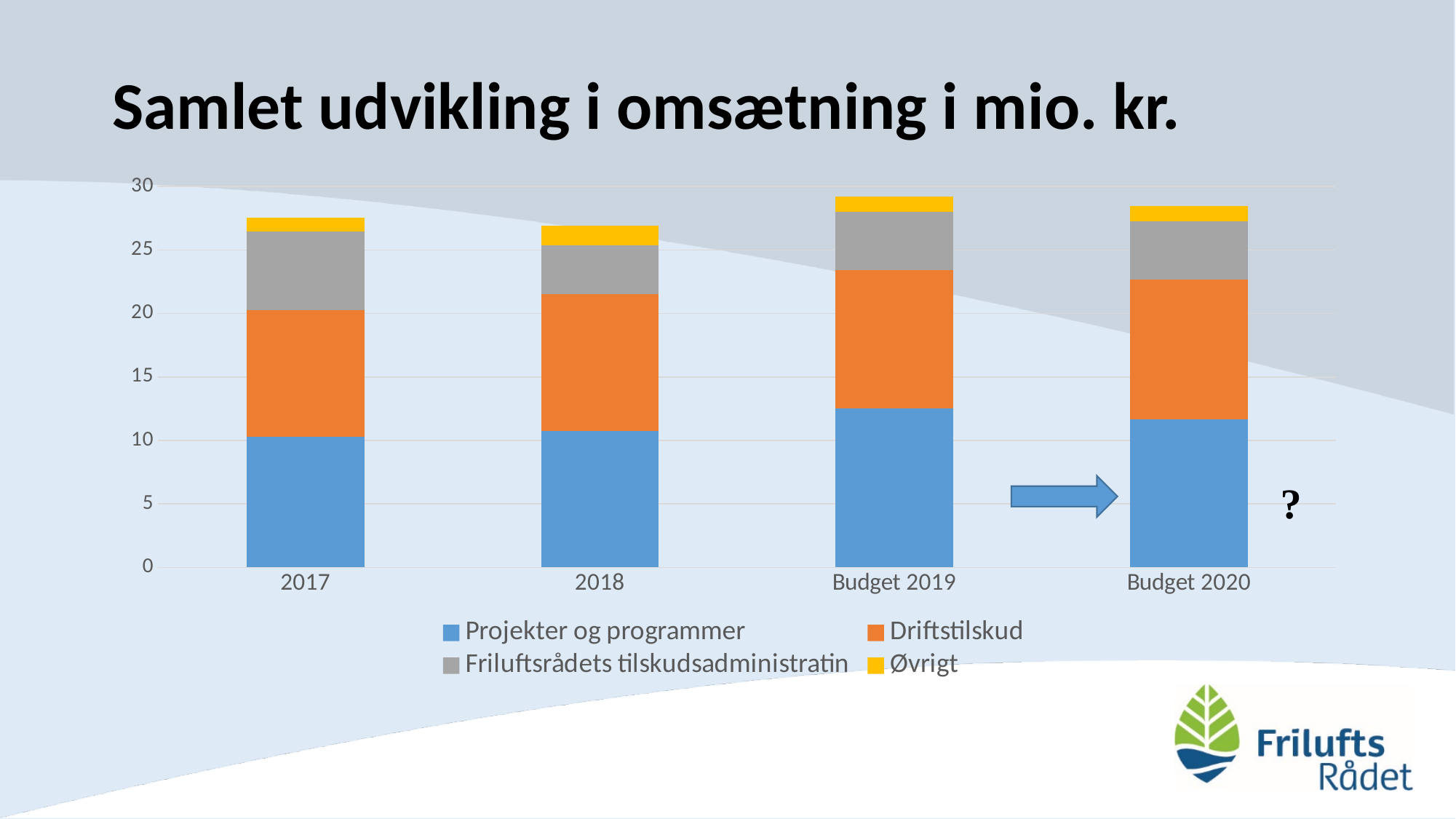
Is the total stacked bar for Budget 2019 greater or less than 30? less Which category has the tallest stacked bar overall? Budget 2019 Does the Projekter og programmer segment rise or fall from 2017 to Budget 2019? rise What is the title of the chart? Samlet udvikling i omsætning i mio. kr. How many categories are shown on the x axis? 4 How many series does the legend list? 4 Which category has the largest Projekter og programmer segment? Budget 2019 Which colour represents the series Øvrigt in the legend? yellow Is the Projekter og programmer value for 2018 greater or less than 15? less Is the Projekter og programmer value for Budget 2019 greater or less than 10? greater What kind of chart is shown on the slide? stacked bar chart Which is larger, the Projekter og programmer segment for 2017 or for Budget 2019? Budget 2019